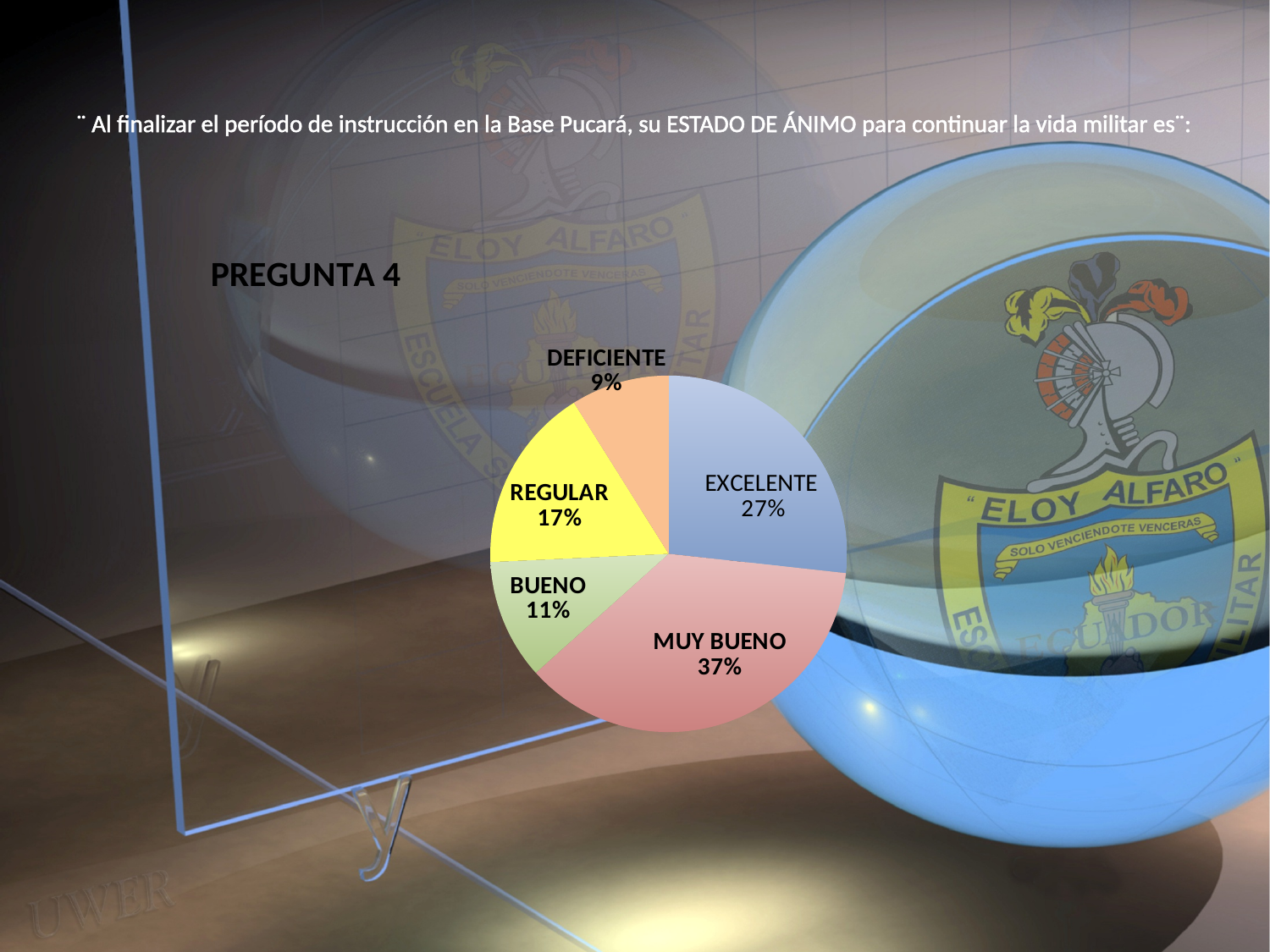
What percentage of the pie is labelled MUY BUENO? 37% Which category has the largest slice of the pie? MUY BUENO What percentage of the pie is labelled DEFICIENTE? 9% How many slices does the pie chart have? 5 Which is larger, the REGULAR slice or the BUENO slice? REGULAR Which category has the smallest slice of the pie? DEFICIENTE What percentage of the pie is labelled BUENO? 11% What kind of chart is shown on the slide? pie chart What percentage of the pie is labelled EXCELENTE? 27% What percentage of the pie is labelled REGULAR? 17% What is the difference in percentage points between MUY BUENO and EXCELENTE? 10 What colour is the MUY BUENO slice? pink